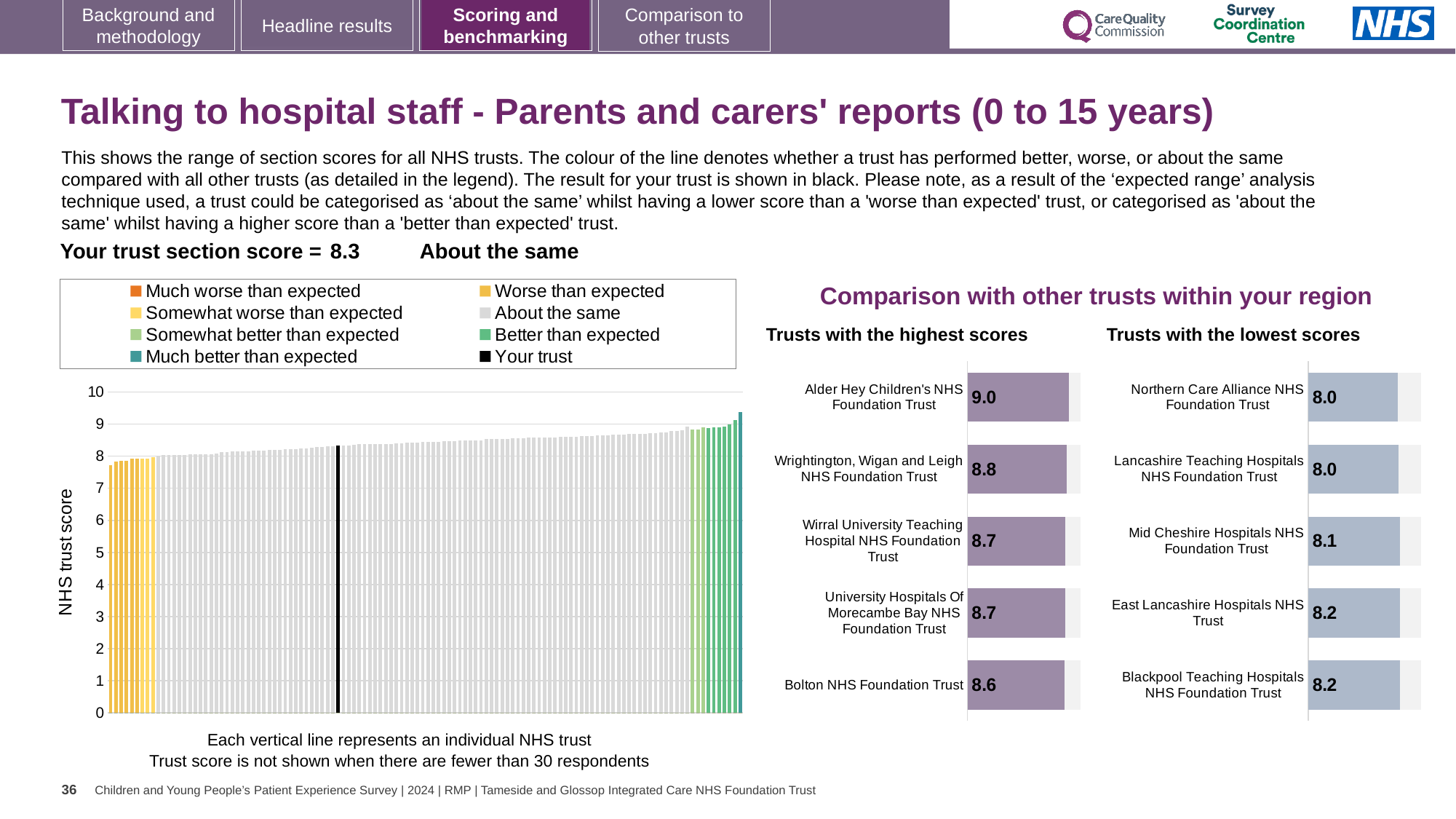
How many entries does the legend of the main 'NHS trust score' chart on the left list? 8 In the 'Trusts with the highest scores' chart, which trust has the lowest score? Bolton NHS Foundation Trust In the main 'NHS trust score' chart on the left, do the trust scores rise or fall from left to right? Rise In the 'Trusts with the highest scores' chart, what is the difference between the scores of Alder Hey Children's NHS Foundation Trust and Bolton NHS Foundation Trust? 0.4 In the main 'NHS trust score' chart on the left, is the value for the leftmost trust greater or less than 8? less In the 'Trusts with the highest scores' chart, what is the score for Bolton NHS Foundation Trust? 8.6 In the 'Trusts with the highest scores' chart, what is the score for Alder Hey Children's NHS Foundation Trust? 9.0 What kind of chart is the main 'NHS trust score' chart on the left of the slide? Bar chart How many trusts are shown in the 'Trusts with the highest scores' chart? 5 In the 'Trusts with the lowest scores' chart, what is the score for Mid Cheshire Hospitals NHS Foundation Trust? 8.1 In the 'Trusts with the highest scores' chart, which trust has the highest score? Alder Hey Children's NHS Foundation Trust Which has the higher score: Wrightington, Wigan and Leigh NHS Foundation Trust in the highest-scores chart, or Mid Cheshire Hospitals NHS Foundation Trust in the lowest-scores chart? Wrightington, Wigan and Leigh NHS Foundation Trust